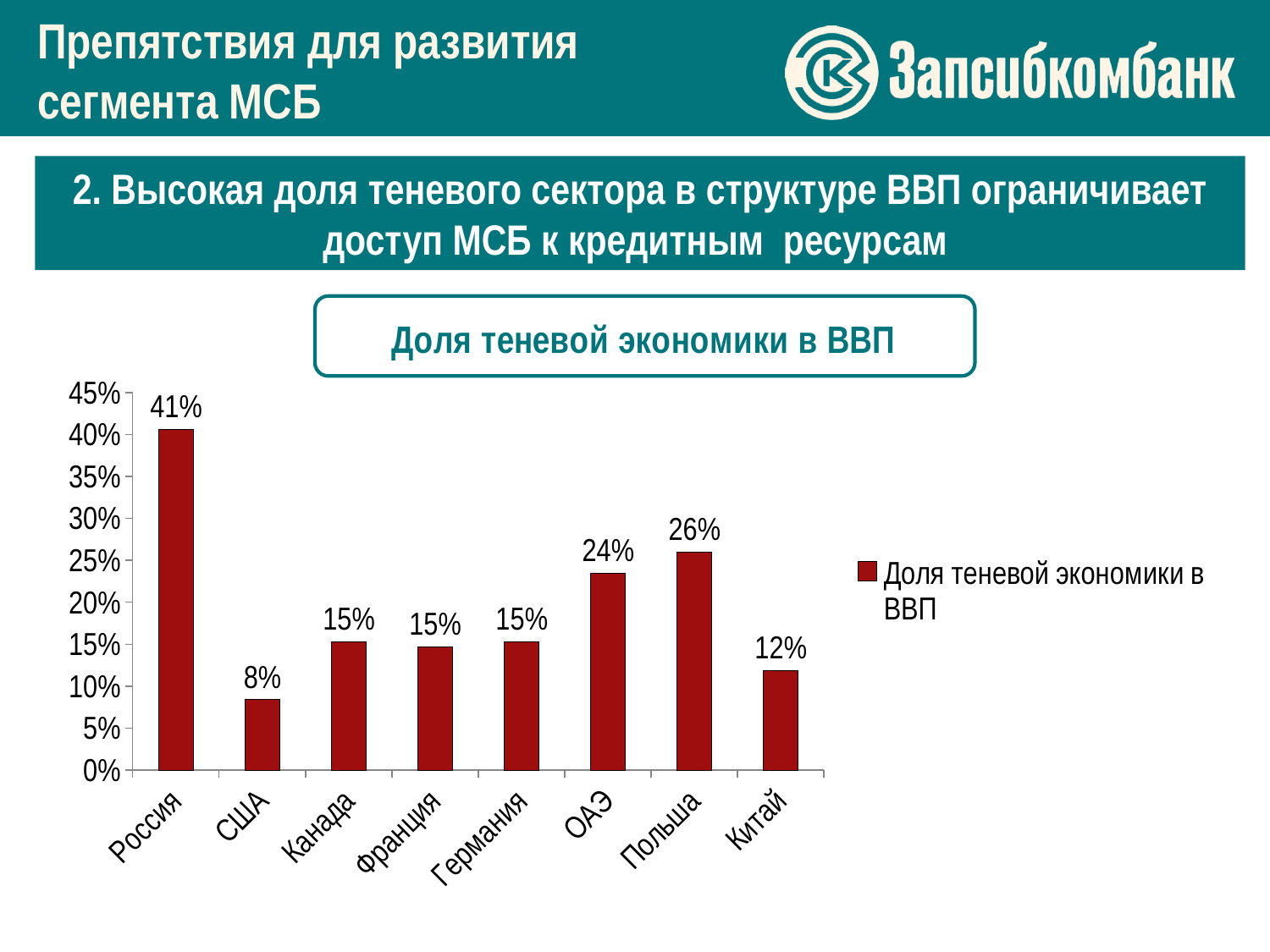
Is the value for Германия greater or less than 20%? less What is the difference between the values for Россия and США? 33% What is the title of the chart? Доля теневой экономики в ВВП Which country has the highest share of shadow economy in GDP? Россия Which is larger, the value for ОАЭ or the value for Польша? Польша What is the value for Китай? 12% How many countries are shown on the chart? 8 What is the value for Россия? 41% What kind of chart is shown on the slide? bar chart What is the value for Польша? 26% Which country has the lowest share of shadow economy in GDP? США What is the value for США? 8%